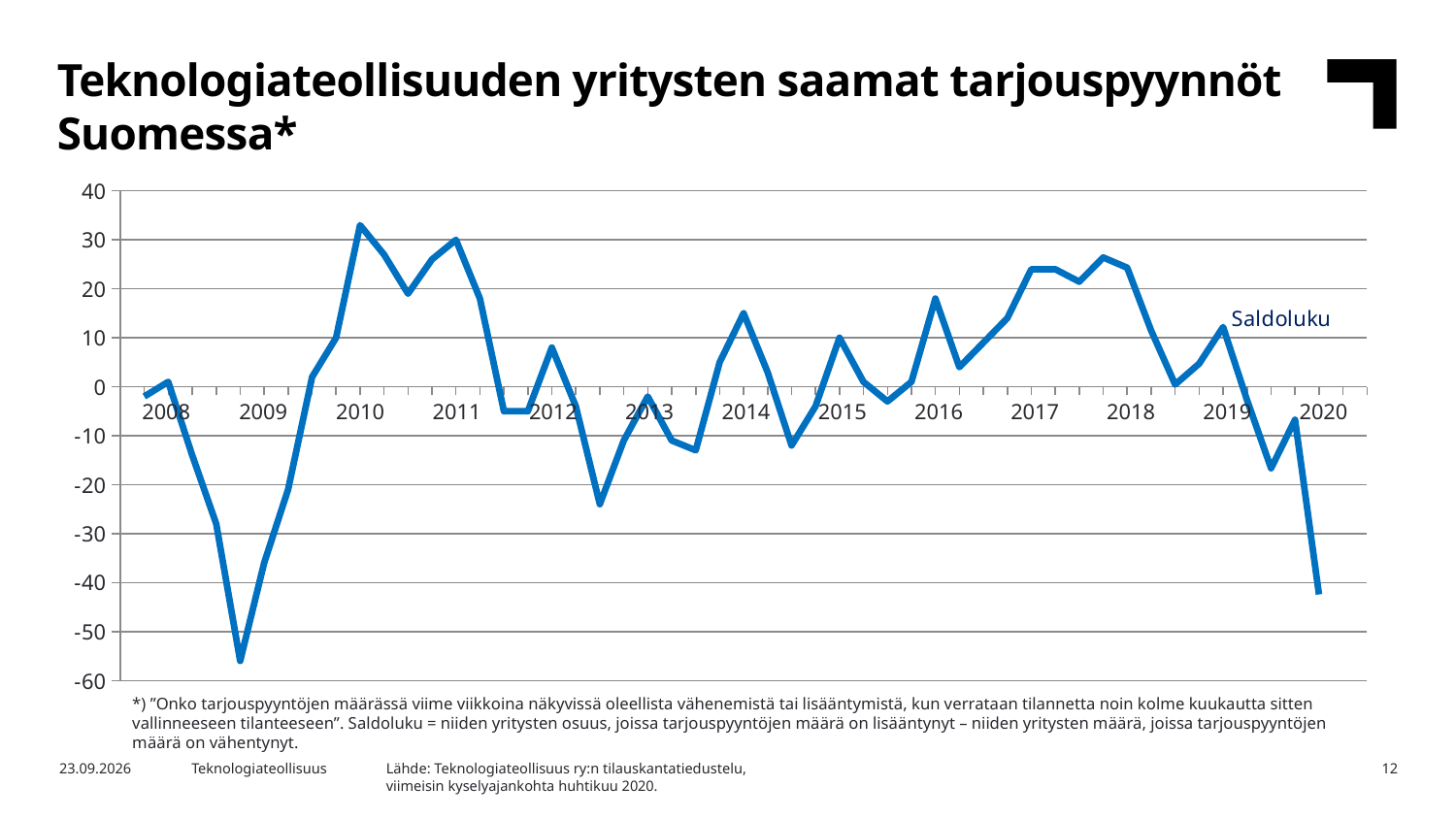
Is the lowest value of the Saldoluku series greater or less than -50? less Which is higher: the peak of the series in 2010 or the peak in 2018? 2010 Is the peak value of the Saldoluku series in 2010 greater or less than 30? greater Does the Saldoluku series rise or fall between 2019 and 2020? fall How many data series does the chart show? 1 Is the final value of the series in 2020 greater or less than -30? less Does the Saldoluku series rise or fall from its low point in early 2009 to its peak in 2010? rise What is the title of the chart on the slide? Teknologiateollisuuden yritysten saamat tarjouspyynnöt Suomessa* What type of chart is shown on the slide? line chart How many year labels are shown on the x axis? 13 What is the name of the series plotted in the chart? Saldoluku